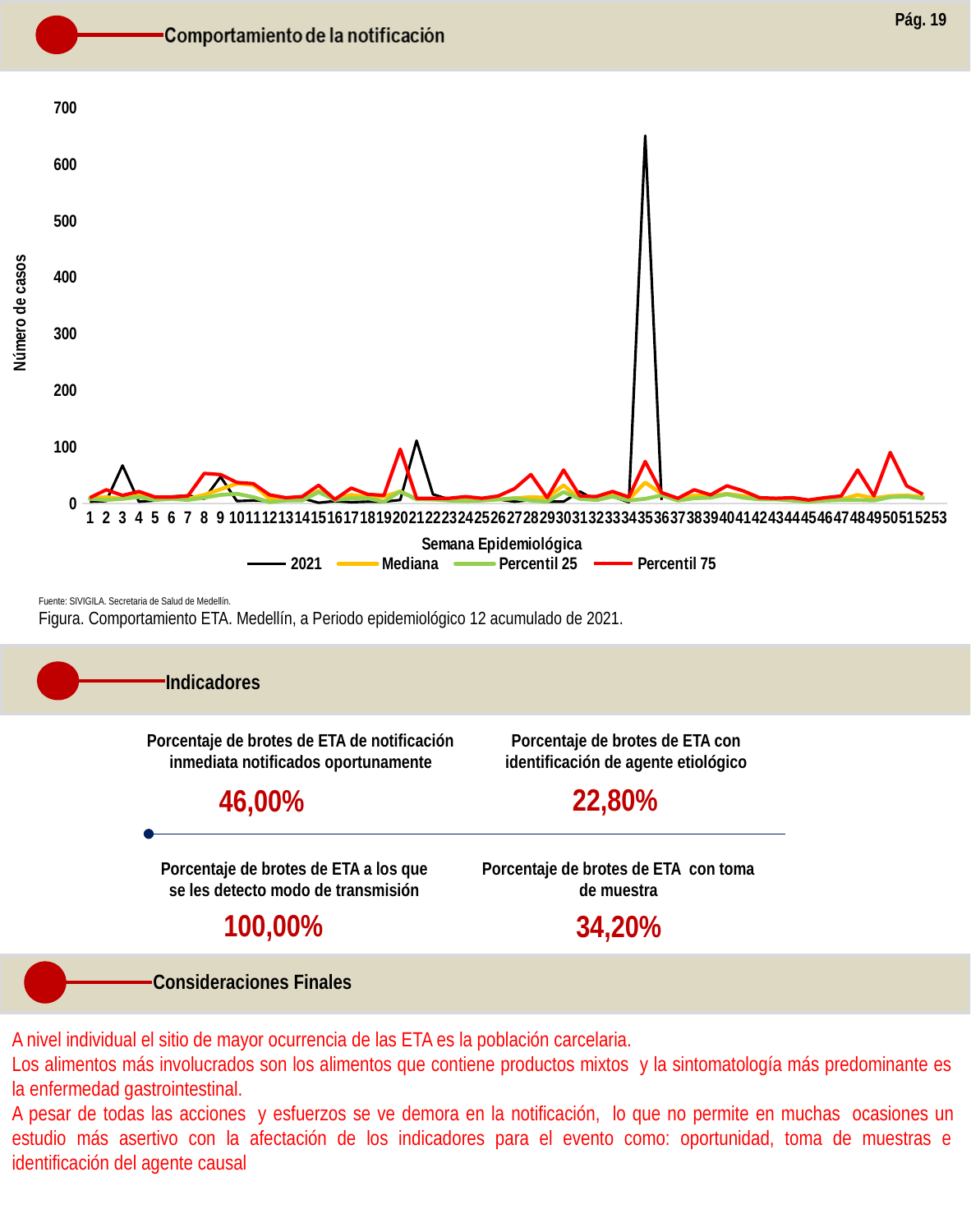
In which epidemiological week does the 2021 series reach its highest value? 35 Is the value of the 2021 series in week 35 greater or less than 500? greater Is the value of the 2021 series in week 35 greater or less than 600? greater What is the title of the chart's vertical axis? Número de casos Is the value of the 2021 series in week 21 greater or less than 200? less How many epidemiological weeks are shown on the x axis of the chart? 53 What kind of chart is shown on the slide? line chart What are the series names listed in the chart legend? 2021, Mediana, Percentil 25, Percentil 75 In week 35, which series has the larger value, 2021 or Percentil 75? 2021 How many series does the chart legend list? 4